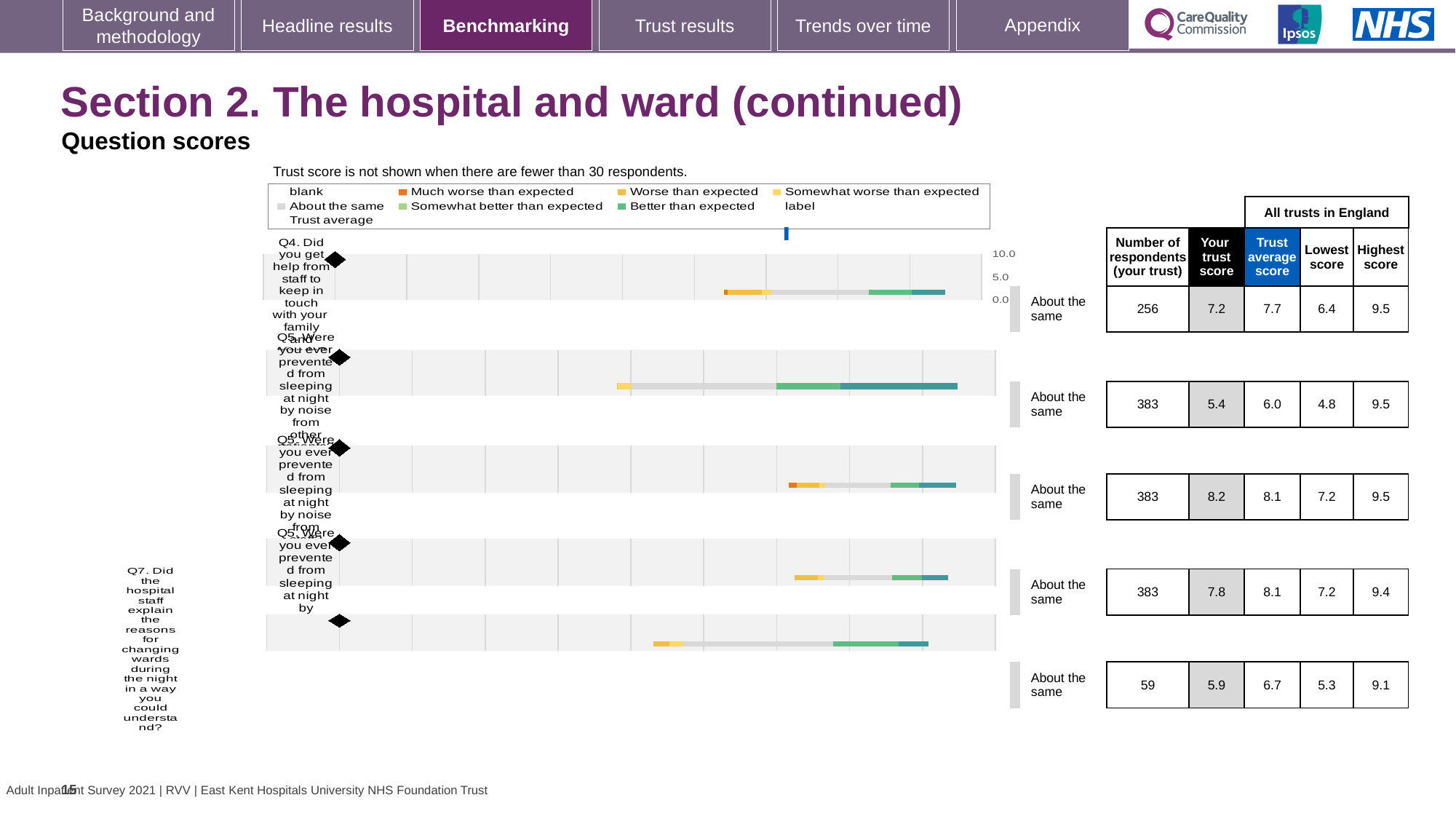
Which question row has the lowest number of respondents? Q7 (59 respondents) What is 'Your trust score' for Q7 (explaining reasons for changing wards during the night)? 5.9 Which is larger for Q4: 'Your trust score' or the 'Trust average score'? Trust average score What is the number of respondents for Q4 (help from staff to keep in touch with family and friends)? 256 How many question rows (bars) are plotted in the chart? 5 What is 'Your trust score' for Q4 (help from staff to keep in touch with family and friends)? 7.2 What is the highest 'Your trust score' value shown in the table? 8.2 What kind of chart is shown on the slide? bar chart What is the highest tick value shown on the chart's score axis? 10.0 In the legend, what label is given to the dark green colour? Better than expected What is the trust average score for Q4 (help from staff to keep in touch with family and friends)? 7.7 What is the difference between the highest score and the lowest score for Q4? 3.1